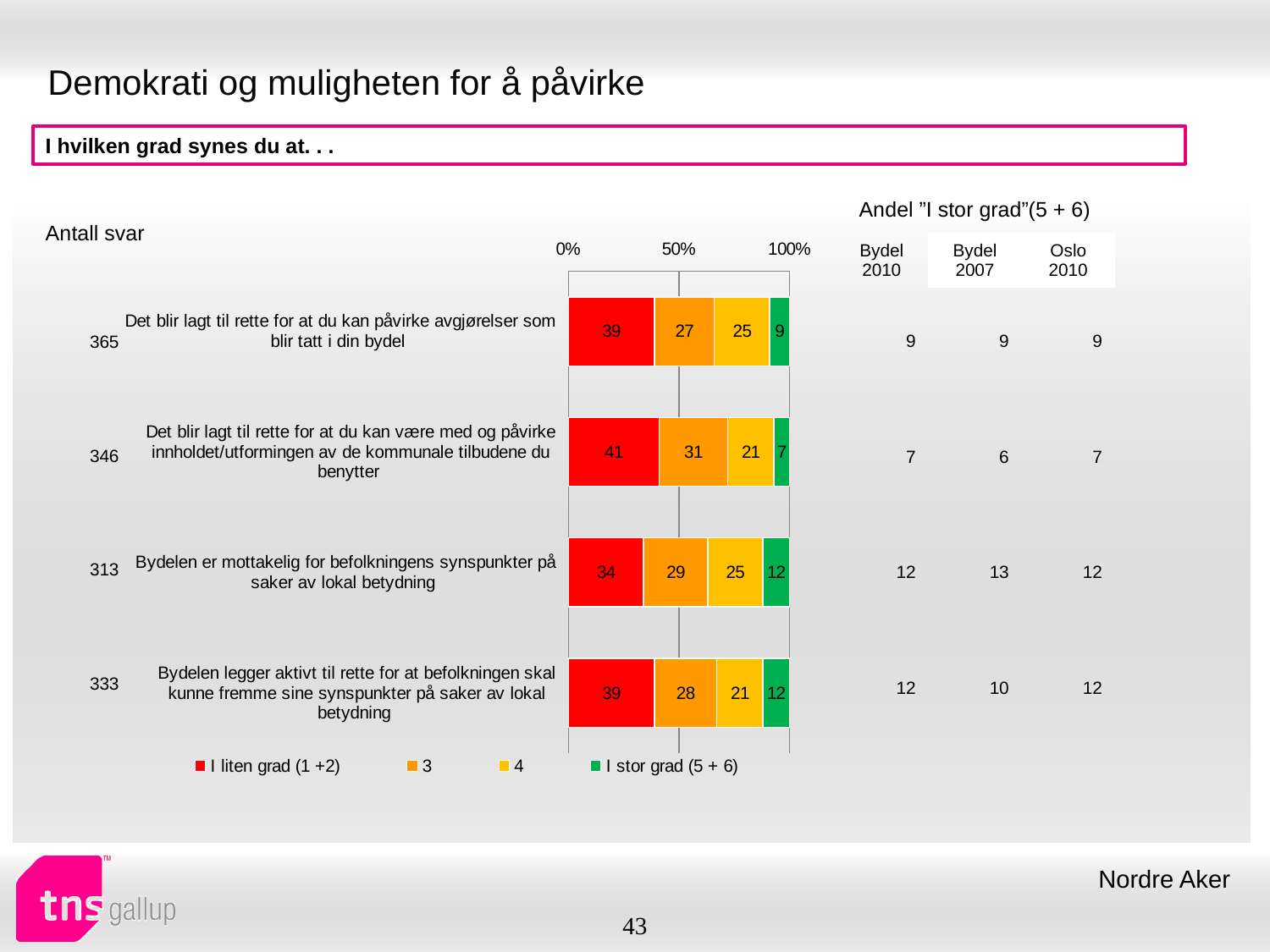
What kind of chart is shown on the slide? stacked bar chart What is the value of series "3" for "Det blir lagt til rette for at du kan være med og påvirke innholdet/utformingen av de kommunale tilbudene du benytter"? 31 How many statements (categories) are plotted in the chart? 4 What colour represents "I stor grad (5 + 6)" in the chart? green What is the value of "I liten grad (1 +2)" for "Bydelen er mottakelig for befolkningens synspunkter på saker av lokal betydning"? 34 Which statement has the highest value for "I liten grad (1 +2)"? Det blir lagt til rette for at du kan være med og påvirke innholdet/utformingen av de kommunale tilbudene du benytter What is the value of "I stor grad (5 + 6)" for "Det blir lagt til rette for at du kan påvirke avgjørelser som blir tatt i din bydel"? 9 What is the difference between the "I liten grad (1 +2)" value and the "I stor grad (5 + 6)" value for "Bydelen legger aktivt til rette for at befolkningen skal kunne fremme sine synspunkter på saker av lokal betydning"? 27 What is the total of the stacked bar for "Bydelen er mottakelig for befolkningens synspunkter på saker av lokal betydning"? 100 Which statement has the lowest value for "I stor grad (5 + 6)"? Det blir lagt til rette for at du kan være med og påvirke innholdet/utformingen av de kommunale tilbudene du benytter Which is larger: the series "4" value for "Det blir lagt til rette for at du kan påvirke avgjørelser som blir tatt i din bydel" or for "Det blir lagt til rette for at du kan være med og påvirke innholdet/utformingen av de kommunale tilbudene du benytter"? Det blir lagt til rette for at du kan påvirke avgjørelser som blir tatt i din bydel How many series does the chart legend list? 4